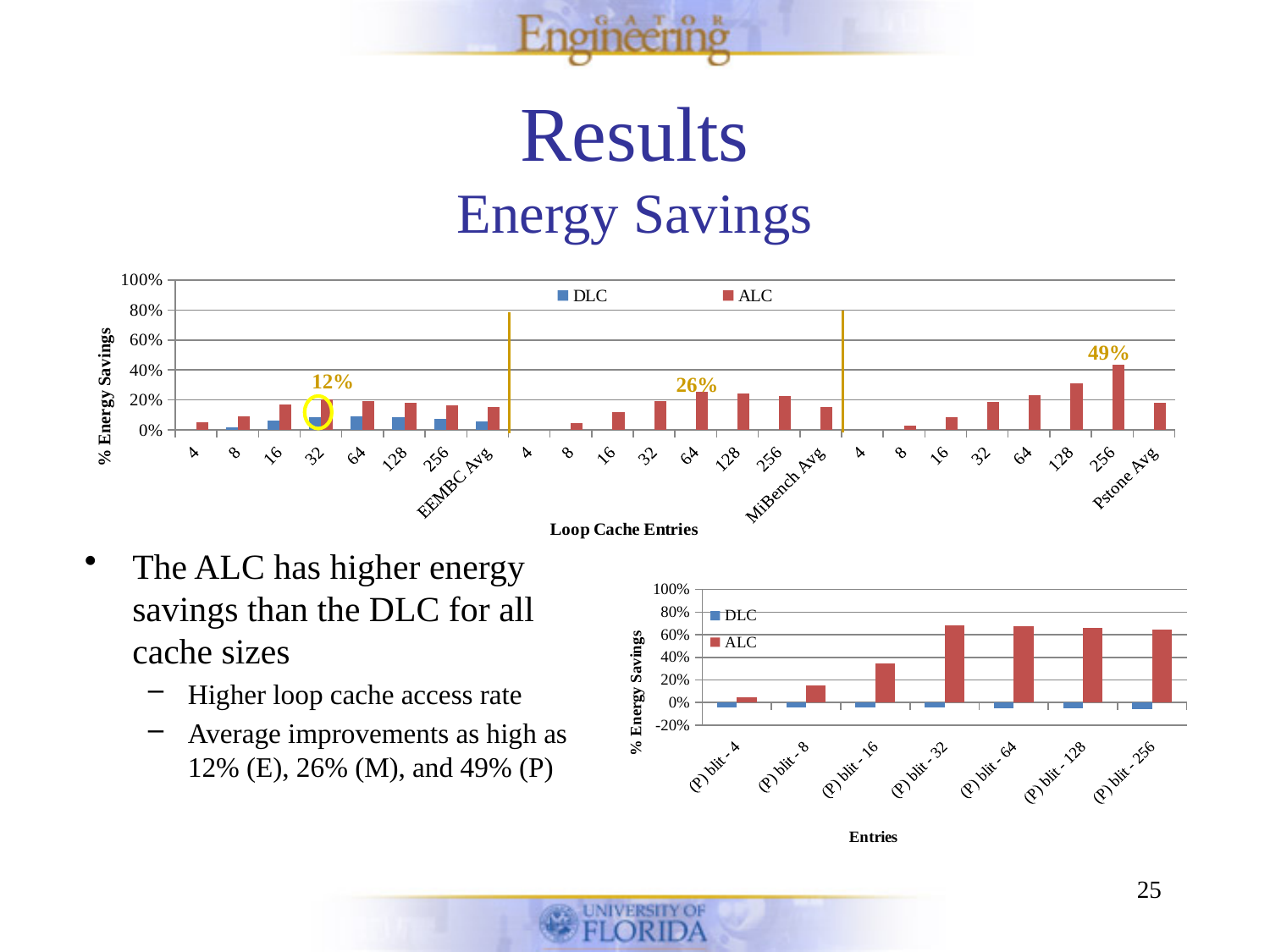
In the top chart, is the ALC value for 64 entries in the MiBench group greater or less than 20%? greater What percentage is annotated above the Pstone group in the top chart? 49% In the top chart, do the ALC values in the Pstone group rise or fall as the entries increase from 4 to 256? rise In the top chart, which is larger: the ALC value for 256 entries in the Pstone group or the ALC value for 8 entries in the Pstone group? 256 entries in the Pstone group How many series does the legend of the top chart list? 2 In the bottom chart, how many categories are shown on the x axis? 7 In the bottom chart, is the ALC value for (P) blit - 32 greater or less than 40%? greater In the bottom chart, is the ALC value for (P) blit - 4 greater or less than 20%? less What kind of chart is the top chart on the slide? bar chart In the top chart, which is larger for 128 entries in the EEMBC group: DLC or ALC? ALC In the bottom chart, which category has the lowest ALC value? (P) blit - 4 What are the two series named in the legend of the top chart? DLC and ALC